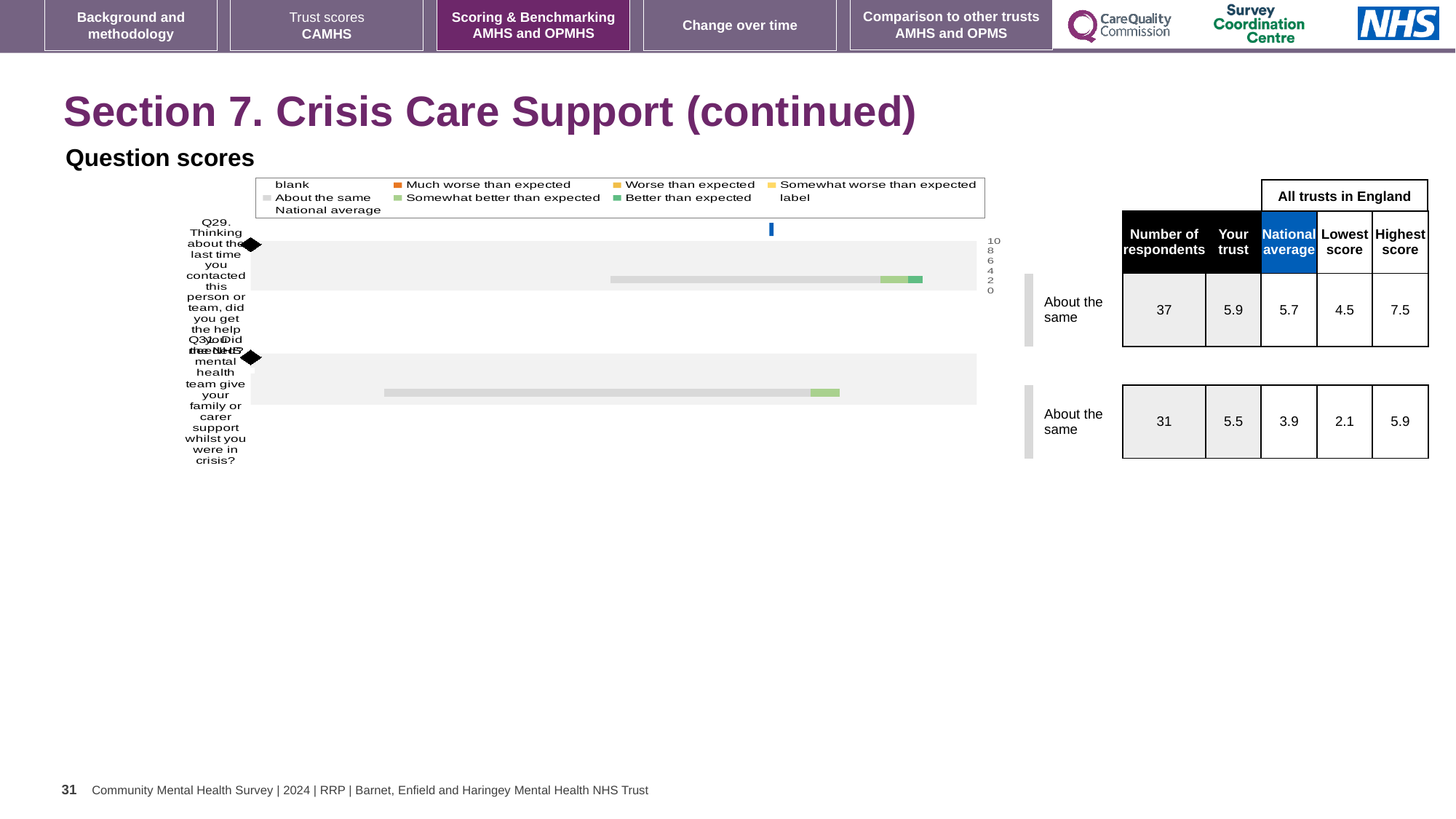
What is the highest score among all trusts in England for Q31? 5.9 What is the 'Your trust' score for Q31 (Did the NHS mental health team give your family or carer support whilst you were in crisis?)? 5.5 What comparison label is shown for Q29 next to the chart? About the same What colour does the legend use for 'Better than expected'? green How many questions (categories) are plotted in the question scores chart? 2 By how much does the trust's score for Q29 exceed the national average for Q29? 0.2 What is the lowest score among all trusts in England for Q31? 2.1 Which question has the higher 'Your trust' score, Q29 or Q31? Q29 What kind of chart is used to show the question scores on this slide? bar chart How many respondents are shown for Q29 in the table next to the chart? 37 What is the national average score for Q29? 5.7 For Q31, which is larger: the trust's score or the national average? Your trust (5.5)